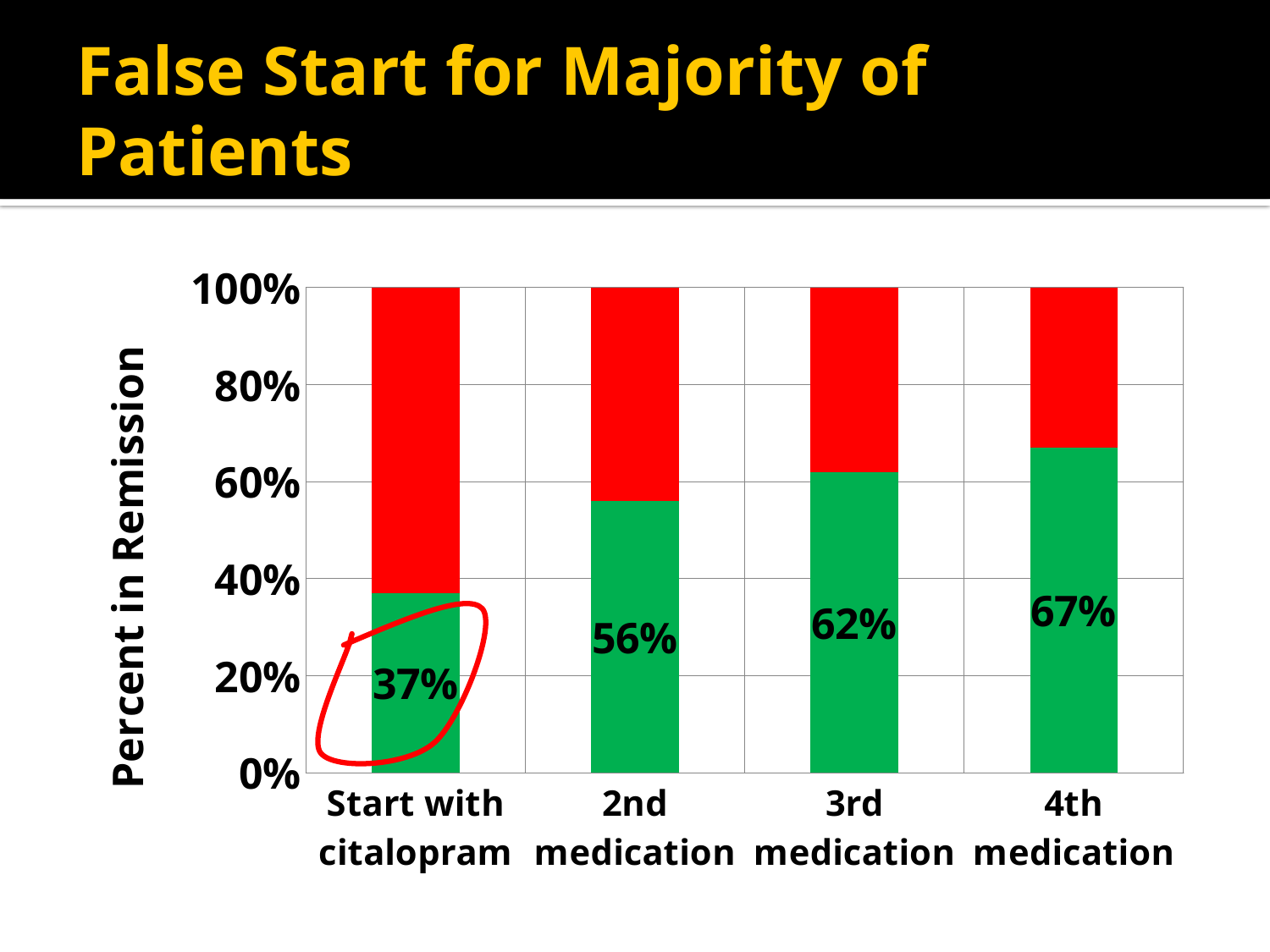
How many categories are shown on the x axis? 4 What is the percent in remission for 'Start with citalopram'? 37% What is the percent in remission for '2nd medication'? 56% What is the percent in remission for '3rd medication'? 62% Is the percent in remission for 'Start with citalopram' greater or less than 40%? less Which has a higher percent in remission, '2nd medication' or '3rd medication'? 3rd medication What kind of chart is shown on the slide? bar chart Which category has the lowest percent in remission? Start with citalopram Which category has the highest percent in remission? 4th medication What is the difference in percent in remission between '4th medication' and 'Start with citalopram'? 30% Do the green remission values rise or fall from 'Start with citalopram' to '4th medication'? rise What is the percent in remission for '4th medication'? 67%